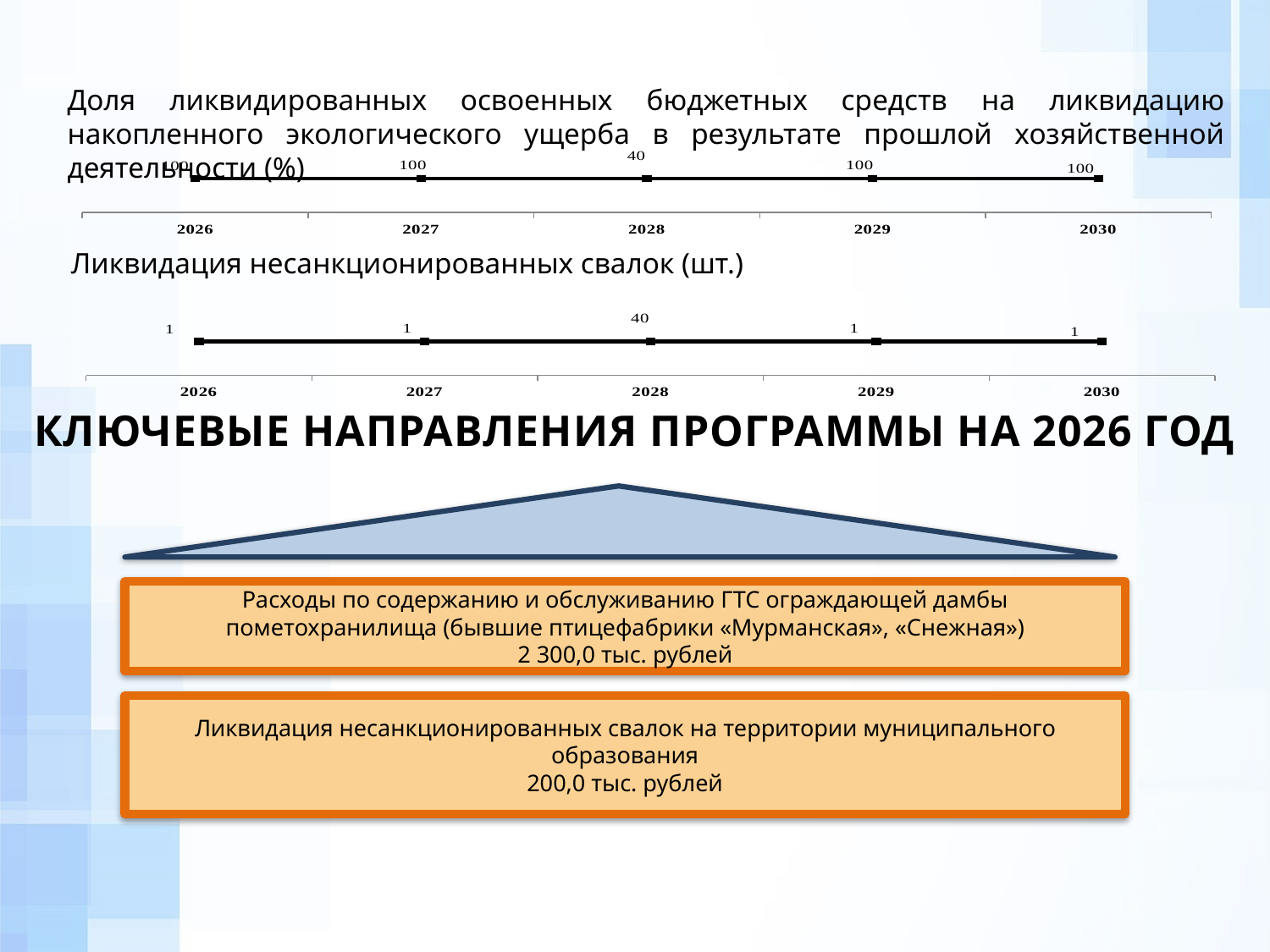
What kind of chart is the one titled "Ликвидация несанкционированных свалок (шт.)"? line chart In the top chart (Доля ликвидированных освоенных бюджетных средств...), what is the value for 2027? 100 In the chart titled "Ликвидация несанкционированных свалок (шт.)", what is the value for 2030? 1 In the top chart (Доля ликвидированных освоенных бюджетных средств...), which is larger, the value for 2029 or the value for 2028? 2029 In the chart titled "Ликвидация несанкционированных свалок (шт.)", which year has the highest labelled value? 2028 In the top chart (Доля ликвидированных освоенных бюджетных средств...), what is the difference between the values for 2027 and 2028? 60 In the top chart (Доля ликвидированных освоенных бюджетных средств...), what is the value for 2030? 100 What is the first year shown on the x axis of the top chart? 2026 In the chart titled "Ликвидация несанкционированных свалок (шт.)", how many years are shown on the x axis? 5 In the chart titled "Ликвидация несанкционированных свалок (шт.)", what is the value for 2028? 40 In the chart titled "Ликвидация несанкционированных свалок (шт.)", what is the value for 2026? 1 In the top chart (Доля ликвидированных освоенных бюджетных средств...), what is the value for 2028? 40